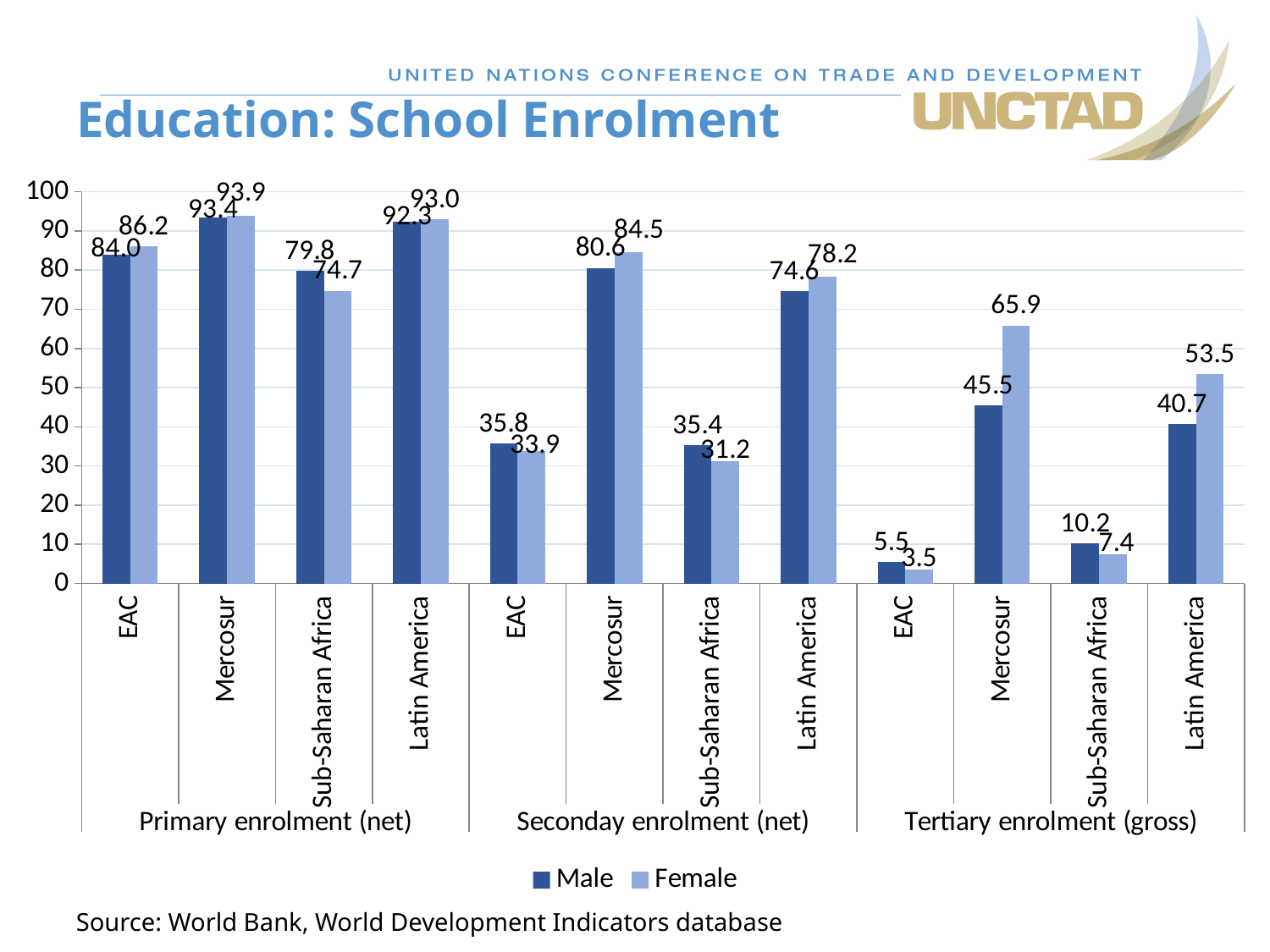
Under Seconday enrolment (net), is the Male or Female value larger for EAC? Male What is the Male value for EAC under Primary enrolment (net)? 84.0 What is the difference between the Male and Female values for Sub-Saharan Africa under Primary enrolment (net)? 5.1 Which region has the lowest Male value under Tertiary enrolment (gross)? EAC What is the Female value for Sub-Saharan Africa under Seconday enrolment (net)? 31.2 What is the source cited below the chart? World Bank, World Development Indicators database How many series does the legend list? 2 What is the Female value for Mercosur under Tertiary enrolment (gross)? 65.9 What is the difference between the Female and Male values for Mercosur under Tertiary enrolment (gross)? 20.4 Which region has the highest Female value under Primary enrolment (net)? Mercosur What is the Male value for Latin America under Tertiary enrolment (gross)? 40.7 What kind of chart is shown on the slide? Bar chart